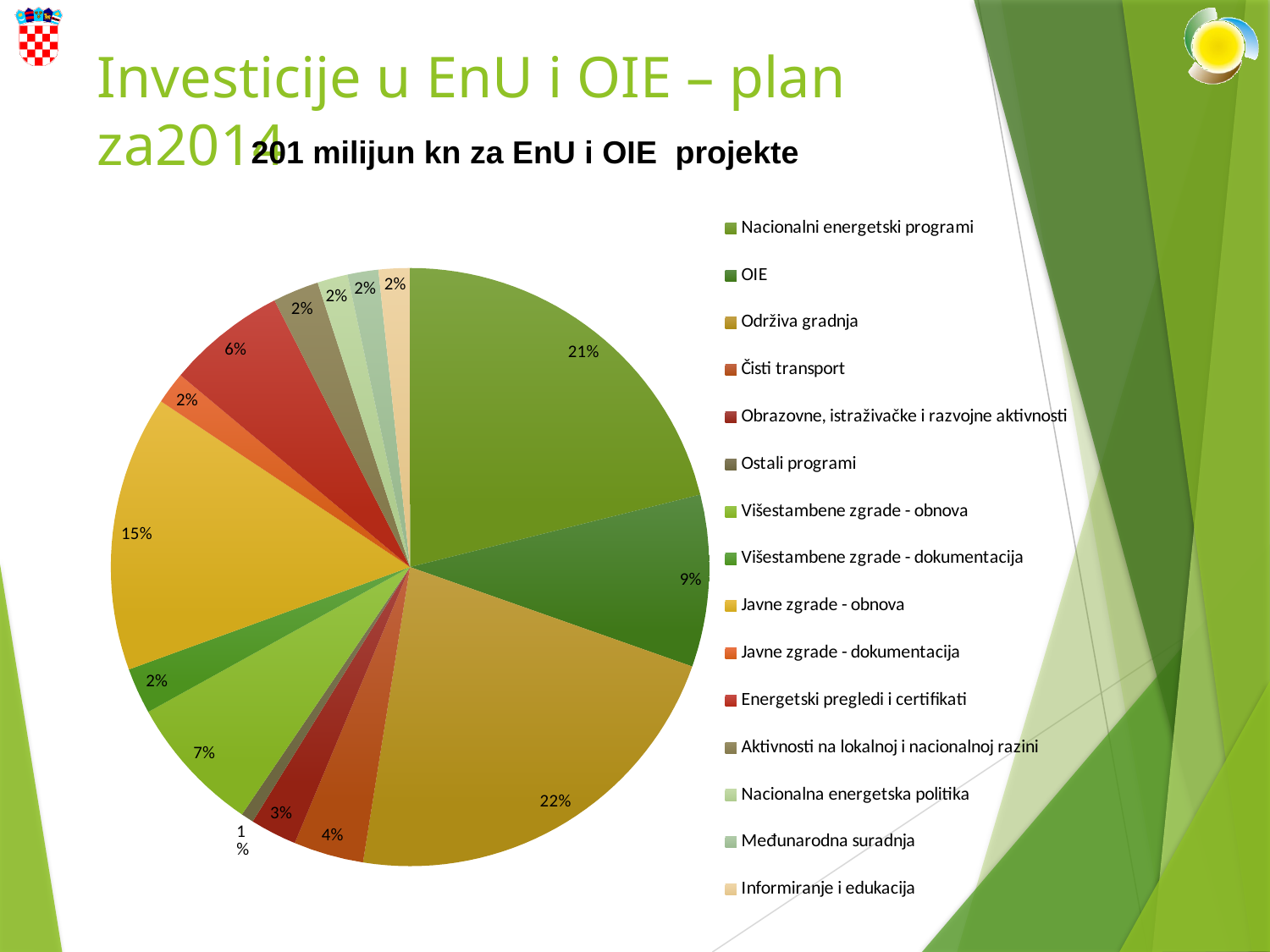
How many categories does the legend of the pie chart list? 15 Which category has the smallest slice of the pie? Ostali programi What is the value shown for Javne zgrade - obnova? 15% What is the difference between the share for Javne zgrade - obnova and the share for Višestambene zgrade - obnova? 8% What share of the pie does Održiva gradnja represent? 22% Which category has the largest slice of the pie? Održiva gradnja What share of the pie does Nacionalni energetski programi represent? 21% What kind of chart is shown on the slide? pie chart What total amount for EnU and OIE projects is stated in the heading above the chart? 201 milijun kn What is the value shown for Energetski pregledi i certifikati? 6% Which is larger, the slice for Višestambene zgrade - obnova or the slice for Čisti transport? Višestambene zgrade - obnova What is the value shown for OIE? 9%